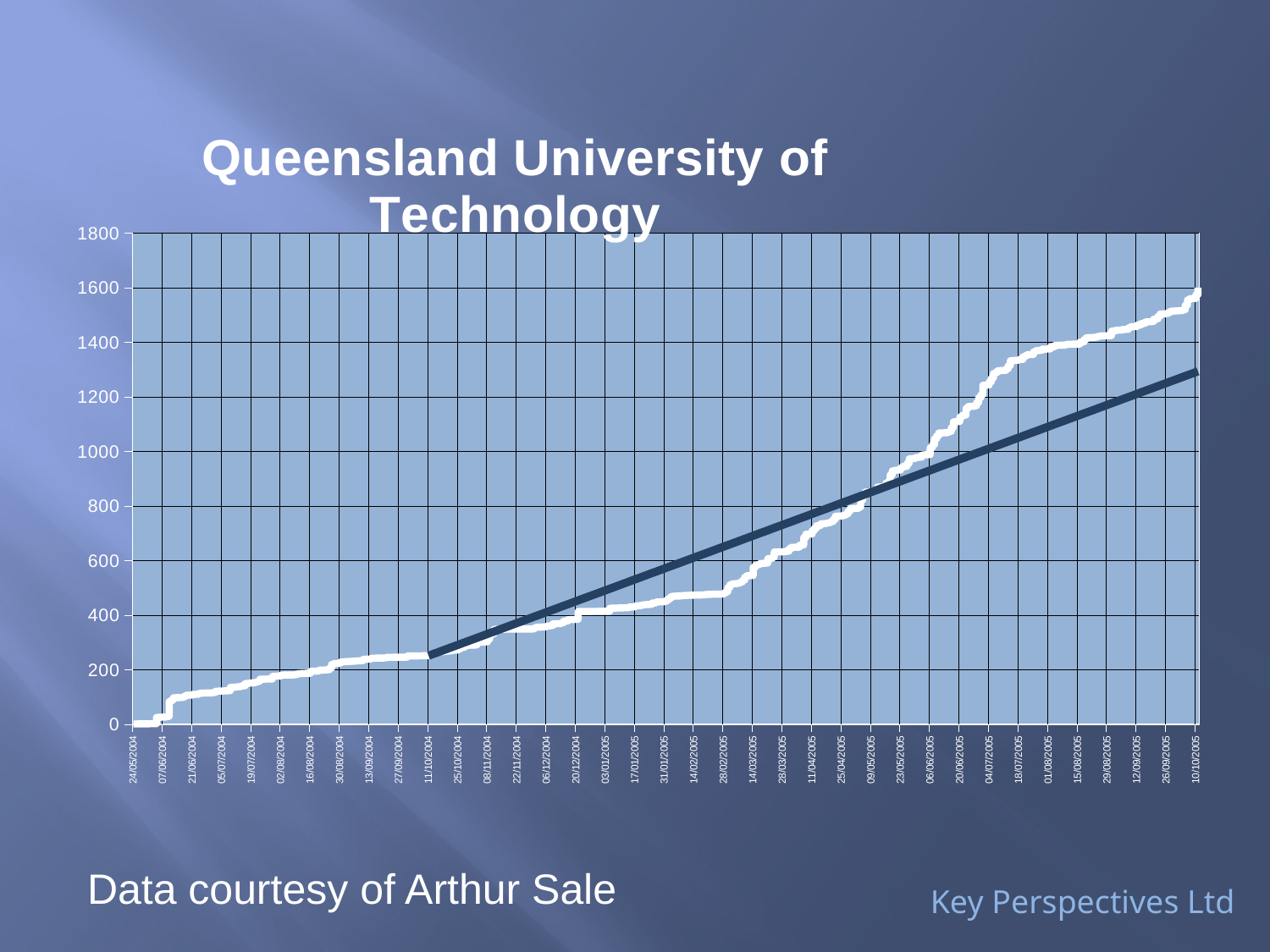
Is the value of the white line at 24/05/2004 greater or less than 200? less Is the value of the white line at 20/06/2005 greater or less than 1000? greater What kind of chart is shown on the slide? line chart Is the value of the white line at 09/05/2005 greater or less than 1000? less At 10/10/2005, which line is higher: the white line or the dark straight line? the white line What is the highest value shown on the y axis? 1800 What is the title of the chart? Queensland University of Technology Do the values of the white line rise or fall over time along the x axis? rise Which is larger: the value of the white line at 10/10/2005 or at 24/05/2004? 10/10/2005